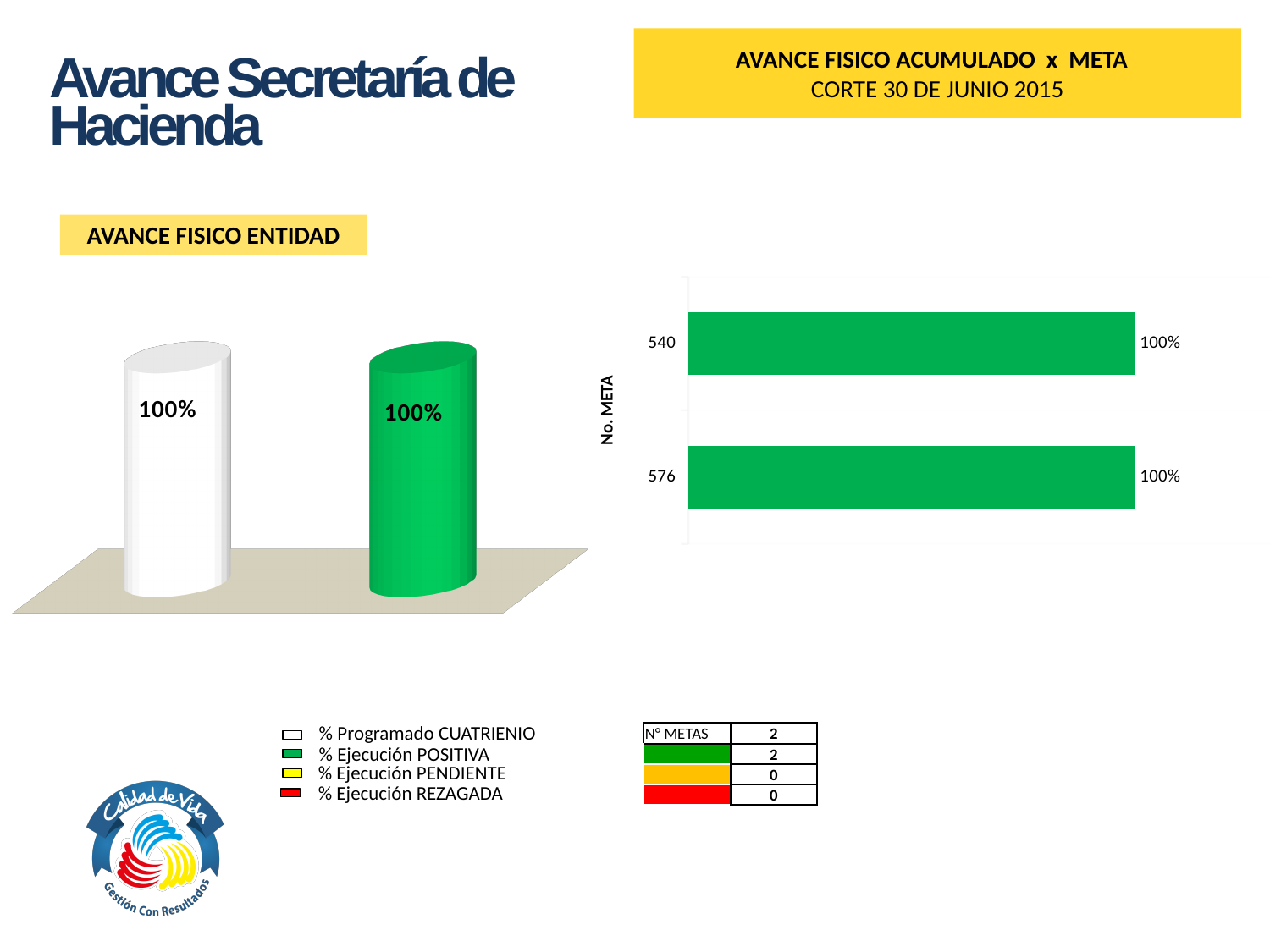
In the AVANCE FISICO ENTIDAD chart, what is the value of the green bar (% Ejecución POSITIVA)? 100% In the AVANCE FISICO ACUMULADO x META chart, what is the value for meta 540? 100% In the AVANCE FISICO ENTIDAD chart, what is the value of the white bar (% Programado CUATRIENIO)? 100% In the AVANCE FISICO ENTIDAD chart, what is the difference between the % Programado CUATRIENIO bar and the % Ejecución POSITIVA bar? 0% How many bars are shown in the AVANCE FISICO ENTIDAD chart? 2 How many entries does the legend below the AVANCE FISICO ENTIDAD chart list? 4 What is the label of the vertical axis in the AVANCE FISICO ACUMULADO x META chart? No. META In the AVANCE FISICO ACUMULADO x META chart, what is the difference between the values for meta 540 and meta 576? 0% In the AVANCE FISICO ACUMULADO x META chart, what is the value for meta 576? 100% What kind of chart is the AVANCE FISICO ACUMULADO x META chart? bar chart How many metas are plotted in the AVANCE FISICO ACUMULADO x META chart? 2 What kind of chart is the AVANCE FISICO ENTIDAD chart? bar chart